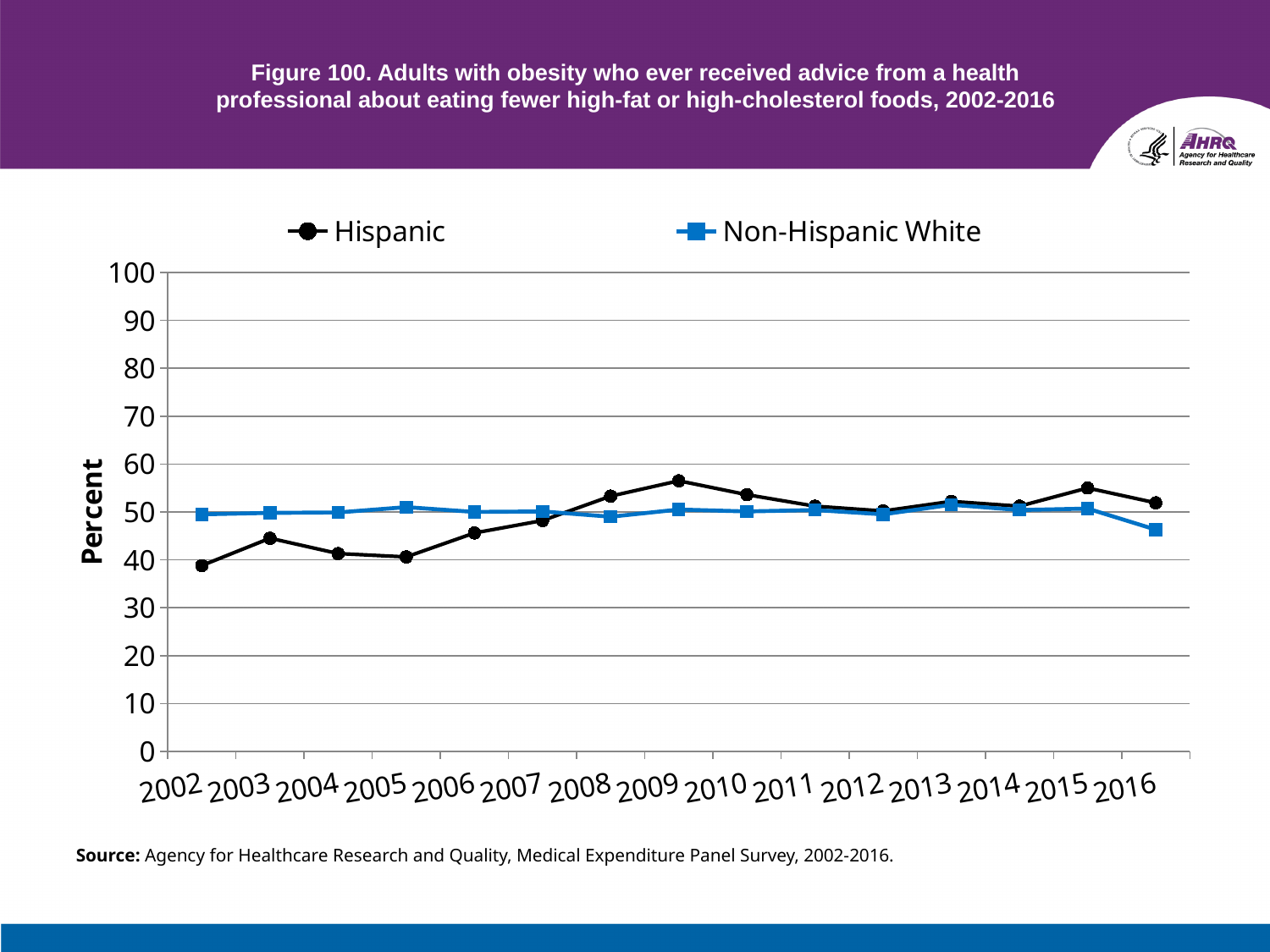
Does the Hispanic series rise or fall from 2002 to 2009? rise How many years are plotted along the x axis? 15 What kind of chart is shown on the slide? line chart In 2009, which series has the larger value, Hispanic or Non-Hispanic White? Hispanic In 2002, which series has the larger value, Hispanic or Non-Hispanic White? Non-Hispanic White Is the Hispanic value for 2009 greater or less than 50? greater In which year is the Non-Hispanic White value lowest? 2016 Is the Non-Hispanic White value for 2016 greater or less than 50? less In which year is the Hispanic value highest? 2009 How many series does the legend list? 2 In which year is the Hispanic value lowest? 2002 Is the Hispanic value for 2005 greater or less than 50? less